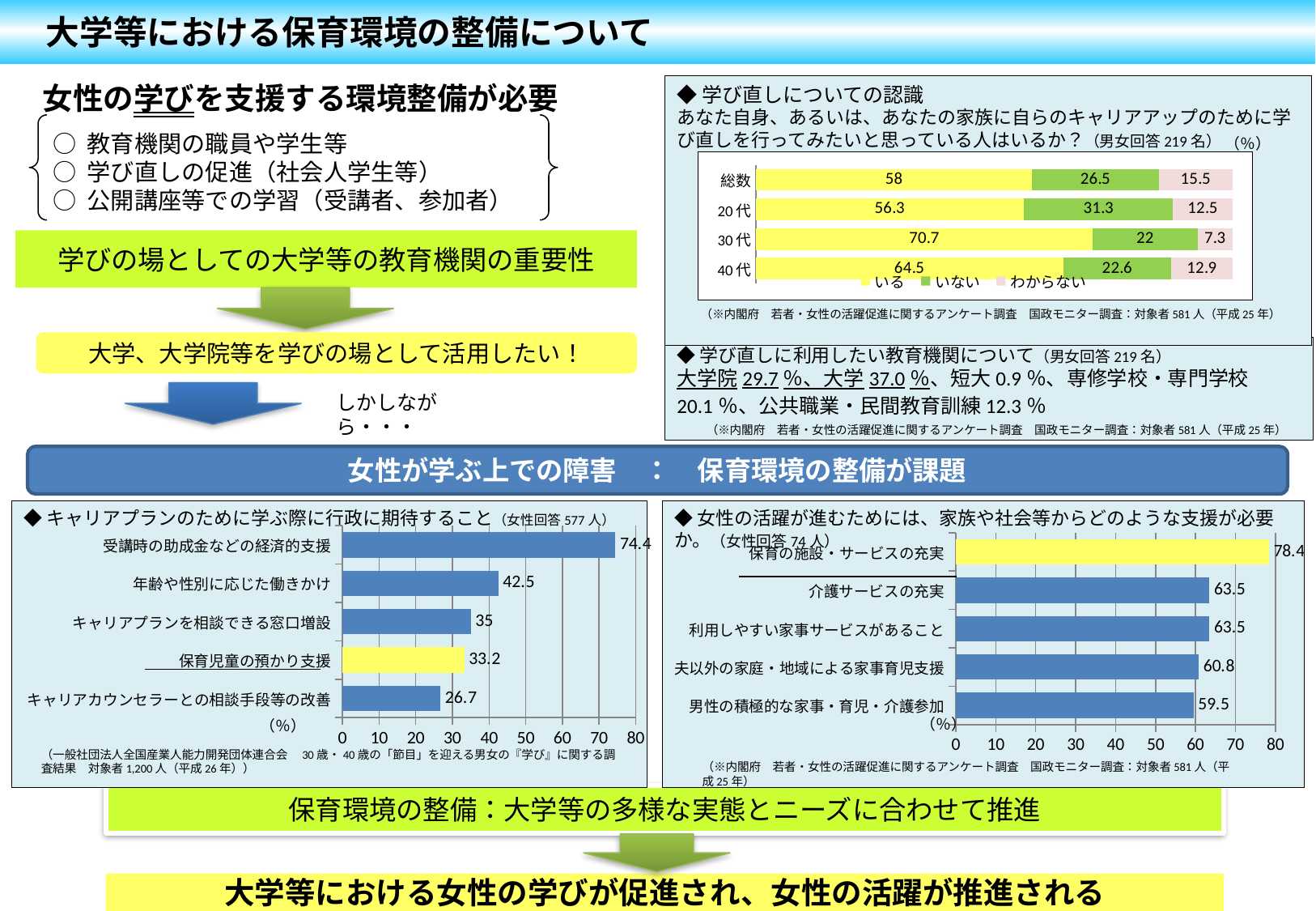
In the top-right chart (学び直しについての認識), what is the value of いる for 30代? 70.7 In the bottom-right chart (女性の活躍が進むためには…支援が必要か), which is larger: 夫以外の家庭・地域による家事育児支援 or 男性の積極的な家事・育児・介護参加? 夫以外の家庭・地域による家事育児支援 In the top-right chart (学び直しについての認識), what is the value of わからない for 20代? 12.5 In the bottom-left chart (キャリアプランのために学ぶ際に行政に期待すること), what is the value for 保育児童の預かり支援? 33.2 What kind of chart is the bottom-right chart (女性の活躍が進むためには…支援が必要か)? bar chart In the top-right chart (学び直しについての認識), what is the difference between the いない values for 20代 and 30代? 9.3 In the bottom-right chart (女性の活躍が進むためには…支援が必要か), what is the value for 保育の施設・サービスの充実? 78.4 In the top-right chart (学び直しについての認識), how many series does the legend list? 3 In the bottom-left chart (キャリアプランのために学ぶ際に行政に期待すること), what is the difference between 受講時の助成金などの経済的支援 and 年齢や性別に応じた働きかけ? 31.9 In the top-right chart (学び直しについての認識), which age group has the highest いる value? 30代 In the bottom-left chart (キャリアプランのために学ぶ際に行政に期待すること), how many categories are shown? 5 In the bottom-left chart (キャリアプランのために学ぶ際に行政に期待すること), which category has the lowest value? キャリアカウンセラーとの相談手段等の改善